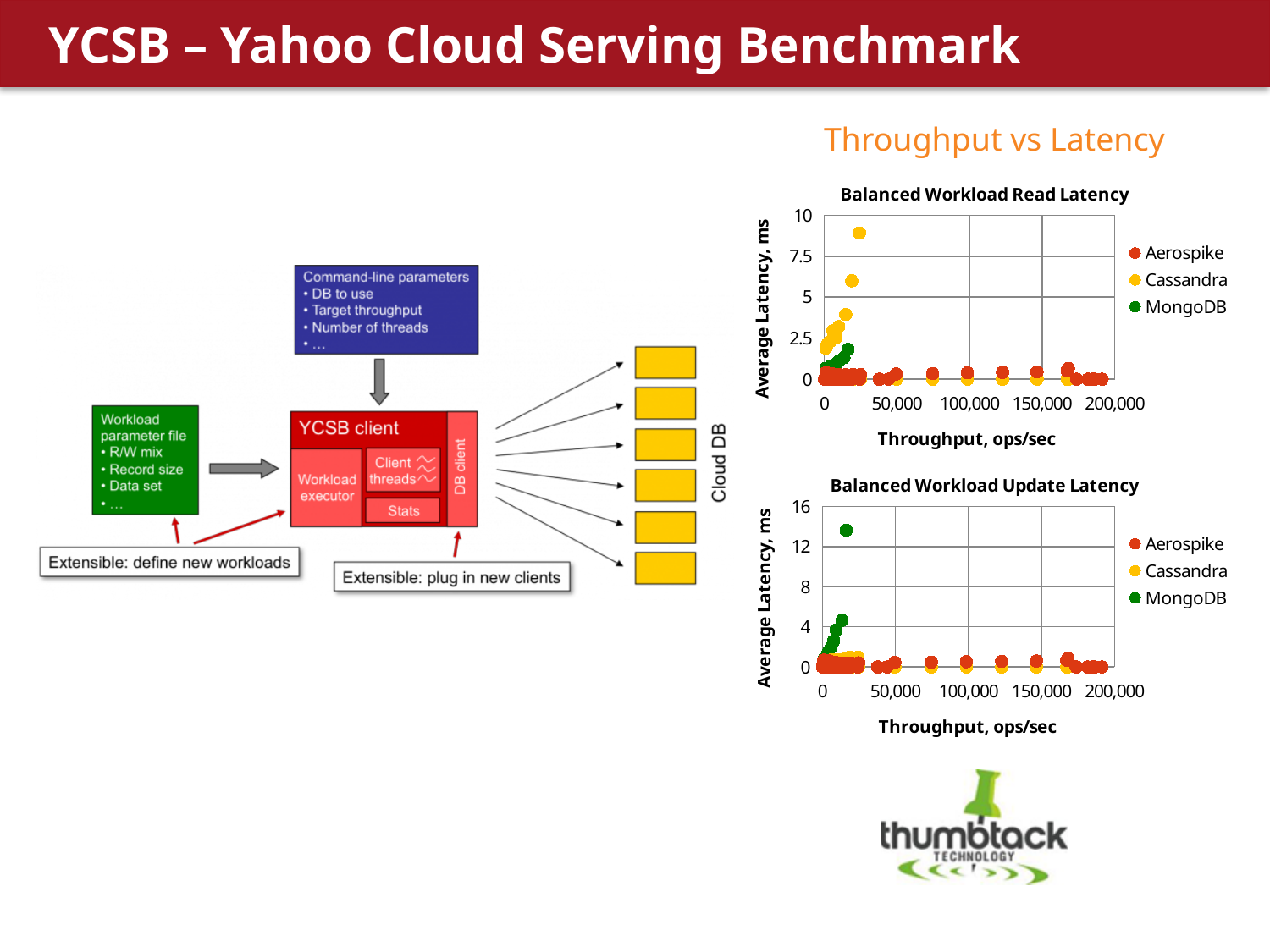
In the "Balanced Workload Read Latency" chart, is the highest Aerospike point greater or less than 2.5 ms? less How many series does the legend of the "Balanced Workload Update Latency" chart list? 3 In the "Balanced Workload Read Latency" chart, which series reaches the highest average latency? Cassandra In the "Balanced Workload Update Latency" chart, is the highest Cassandra point greater or less than 4 ms? less What kind of chart is the "Balanced Workload Read Latency" chart? scatter chart What is the x-axis label of the "Balanced Workload Update Latency" chart? Throughput, ops/sec In the "Balanced Workload Read Latency" chart, which series extends to the highest throughput values on the x axis? Aerospike In the "Balanced Workload Read Latency" chart, is the highest Cassandra point greater or less than 7.5 ms? greater In the "Balanced Workload Update Latency" chart, which series has the higher maximum latency, MongoDB or Aerospike? MongoDB In the "Balanced Workload Update Latency" chart, which series reaches the highest average latency? MongoDB What is the y-axis label of the "Balanced Workload Read Latency" chart? Average Latency, ms